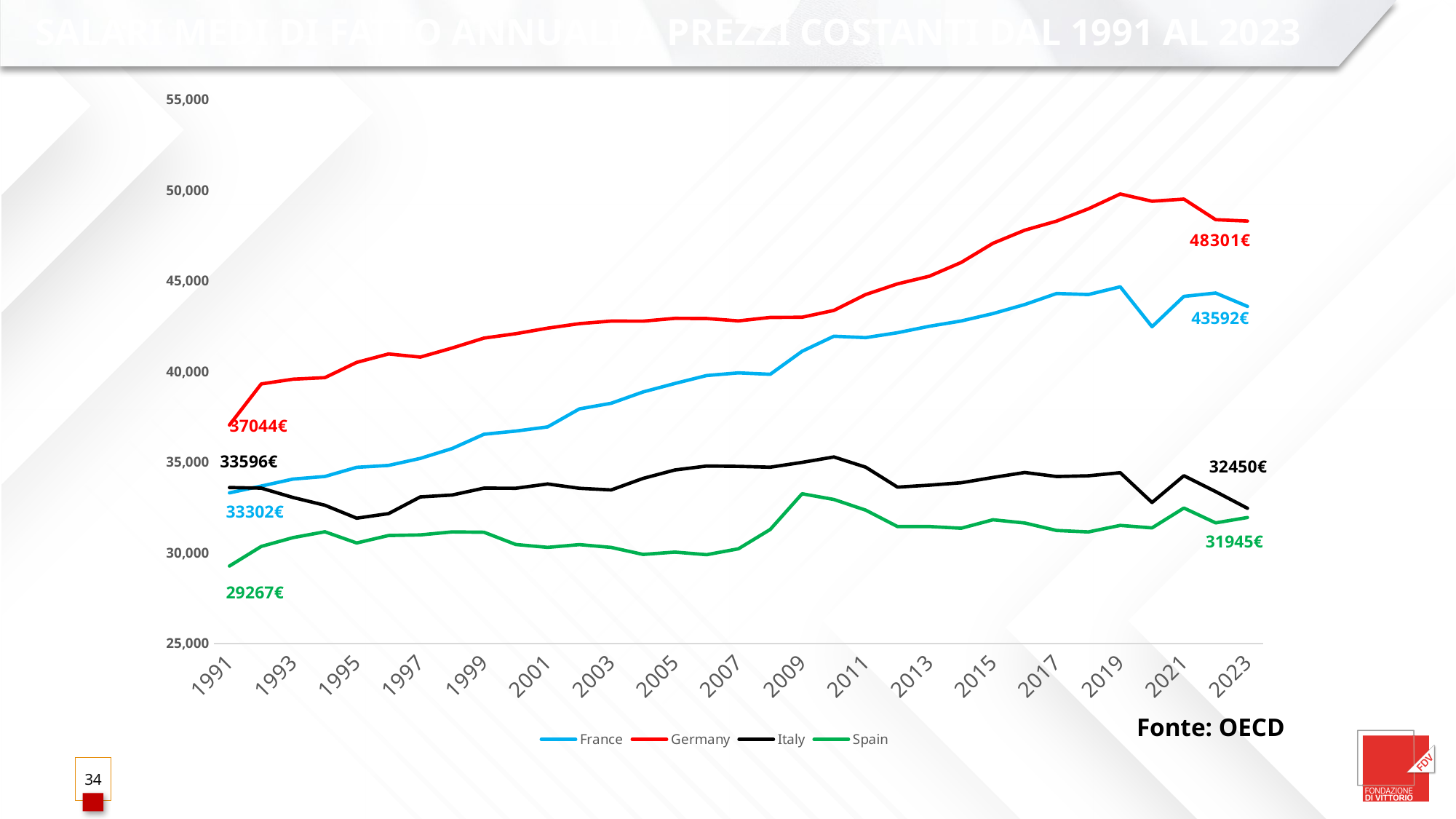
Which is larger, Italy's value in 1991 or Italy's value in 2023? Italy's value in 1991 Which country has the lowest value in 1991? Spain What is the difference between Germany's value in 2023 and its value in 1991? 11257€ Does the France line generally rise or fall from 1991 to 2023? rise Is the value for Germany in 2019 greater or less than 45,000? greater What kind of chart is shown on the slide? line chart What is the value for Italy in 2023? 32450€ What is the value for Spain in 1991? 29267€ What is the value for France in 1991? 33302€ What is the value for Germany in 2023? 48301€ Which country has the highest value in 2023? Germany How many series does the legend list? 4